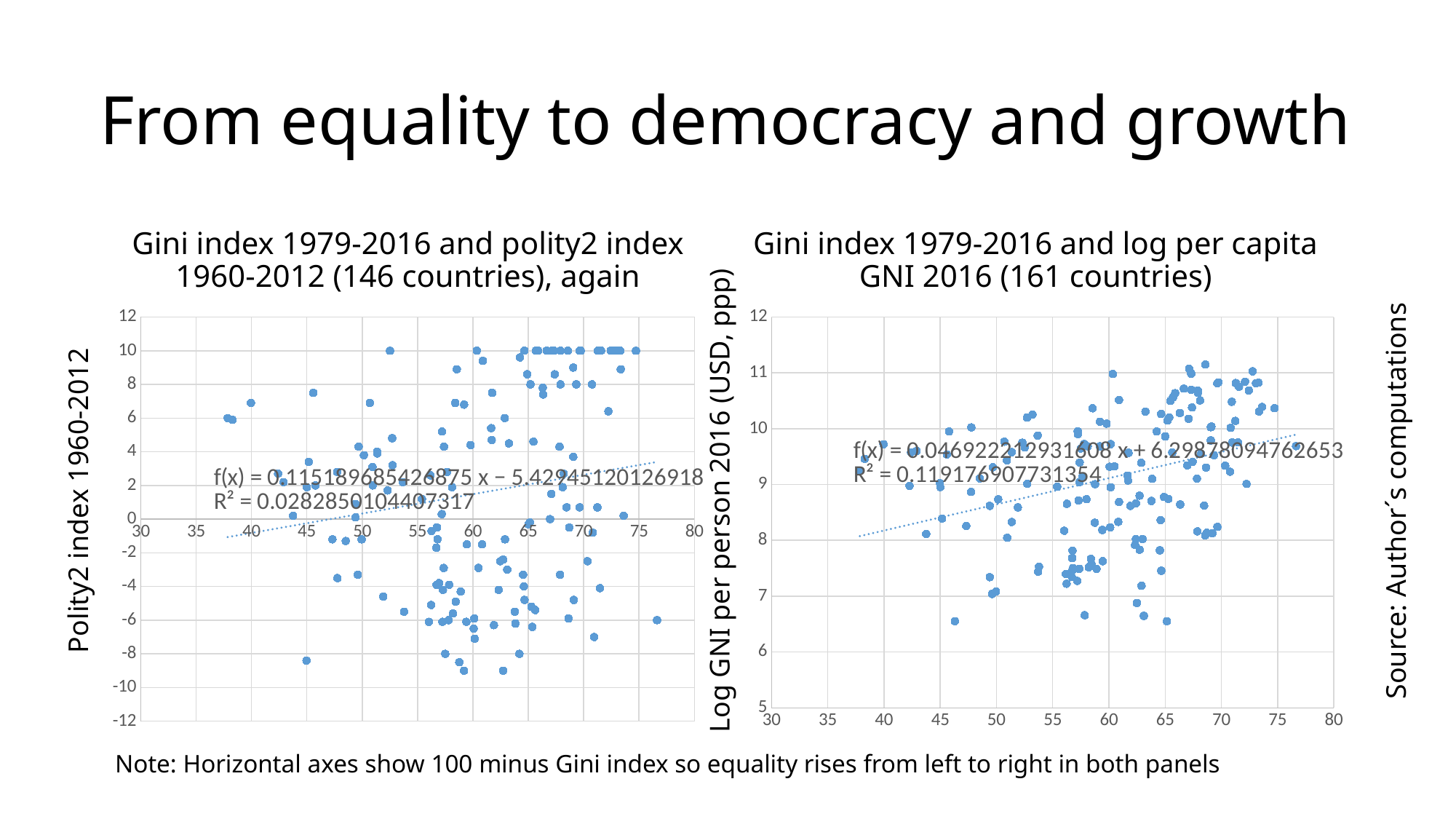
What is the vertical axis label of the right chart? Log GNI per person 2016 (USD, ppp) What kind of chart is the right chart, titled 'Gini index 1979-2016 and log per capita GNI 2016 (161 countries)'? Scatter plot In the right chart (log per capita GNI), what is the intercept of the fitted line f(x)? 6.29878094762653 In the right chart (log per capita GNI), what is the R² value shown for the trendline? 0.119176907731354 What kind of chart is the left chart, titled 'Gini index 1979-2016 and polity2 index 1960-2012 (146 countries), again'? Scatter plot In the right chart (log per capita GNI), how many countries are plotted according to the title? 161 In the left chart (polity2 index), how many countries are plotted according to the title? 146 What is the highest tick value on the vertical axis of the left chart (polity2 index)? 12 In the left chart (polity2 index), what is the R² value shown for the trendline? 0.0282850104407317 In the right chart (log per capita GNI), does the trendline rise or fall as the horizontal axis increases? Rises In the left chart (polity2 index), what is the slope of the fitted line f(x)? 0.115189685426875 Which chart has the higher R² value, the left chart (polity2 index) or the right chart (log per capita GNI)? The right chart (log per capita GNI)